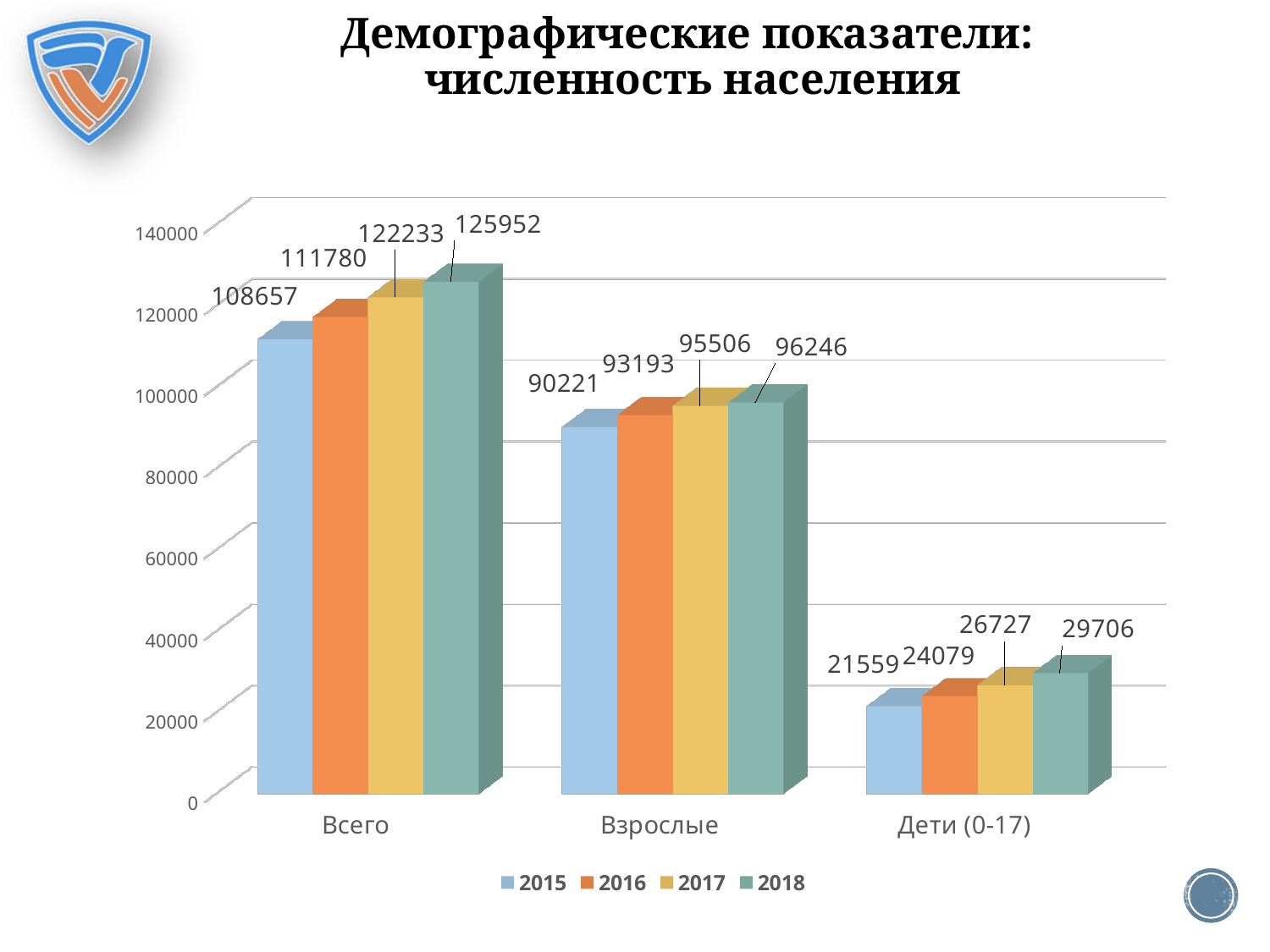
Which is larger: the 2017 value for Взрослые or the 2016 value for Всего? 2016 value for Всего What kind of chart is shown on the slide? bar chart What is the value for Всего in 2018? 125952 Which category has the lowest value in 2016? Дети (0-17) How many series does the legend list? 4 Which year has the highest value for Взрослые? 2018 Do the values for Дети (0-17) rise or fall from 2015 to 2018? rise What is the value for Дети (0-17) in 2017? 26727 How many categories are shown on the x axis? 3 What is the difference between the 2018 and 2015 values for Всего? 17295 What is the difference between the 2017 and 2016 values for Дети (0-17)? 2648 What is the value for Взрослые in 2015? 90221